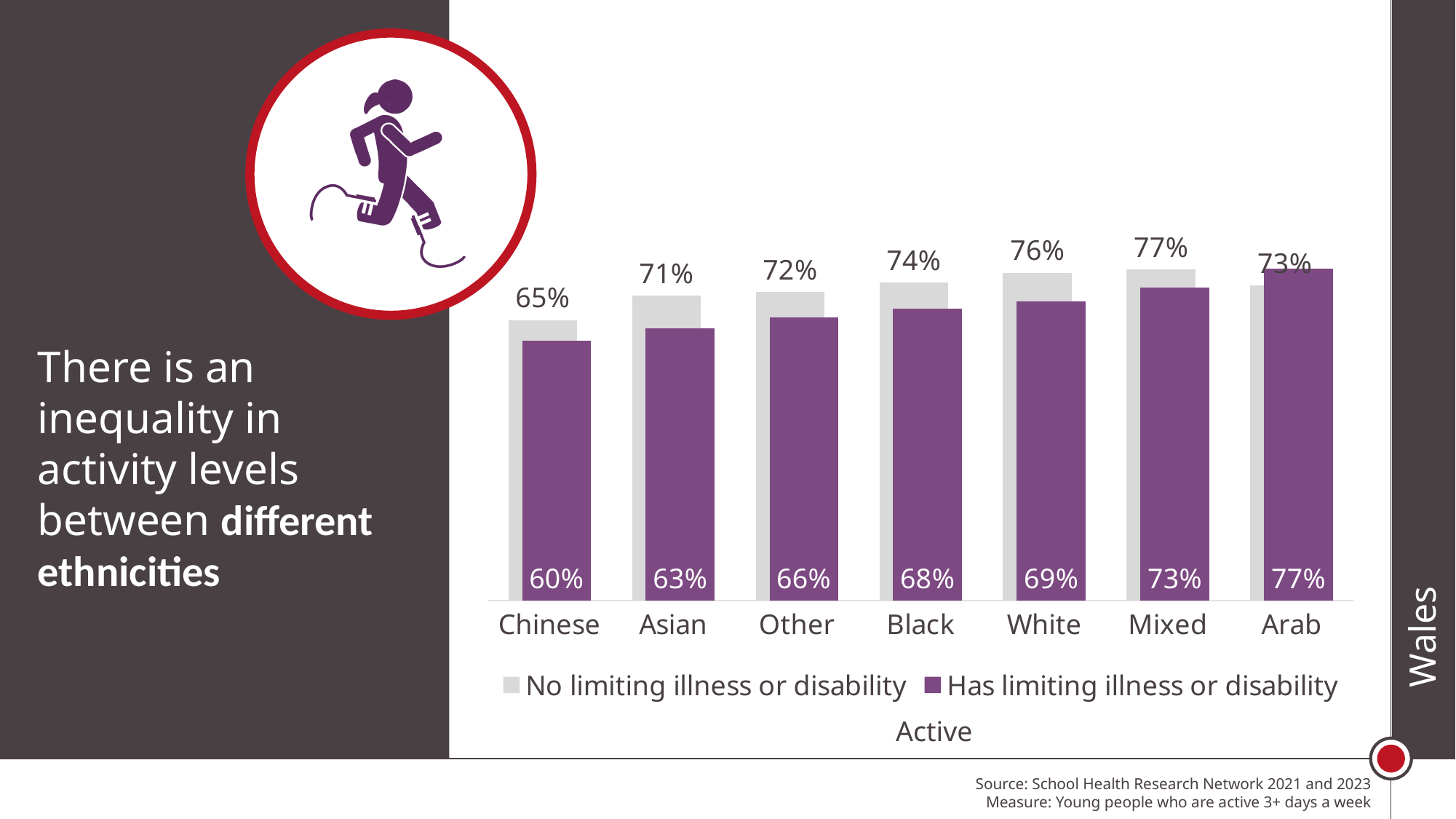
How many ethnicity categories are shown on the x axis? 7 What kind of chart is shown on the slide? Bar chart What is the value for Arab in the 'Has limiting illness or disability' series? 77% How many series does the legend list? 2 What is the difference between the 'No limiting illness or disability' and 'Has limiting illness or disability' values for Asian? 8% Which is larger: the 'Has limiting illness or disability' value for White or for Mixed? Mixed For Arab, which series has the larger value: 'No limiting illness or disability' or 'Has limiting illness or disability'? Has limiting illness or disability Which category has the highest value in the 'No limiting illness or disability' series? Mixed Which category has the lowest value in the 'Has limiting illness or disability' series? Chinese What is the value for Chinese in the 'No limiting illness or disability' series? 65% What is the value for Black in the 'Has limiting illness or disability' series? 68% What is the x-axis title of the chart? Active